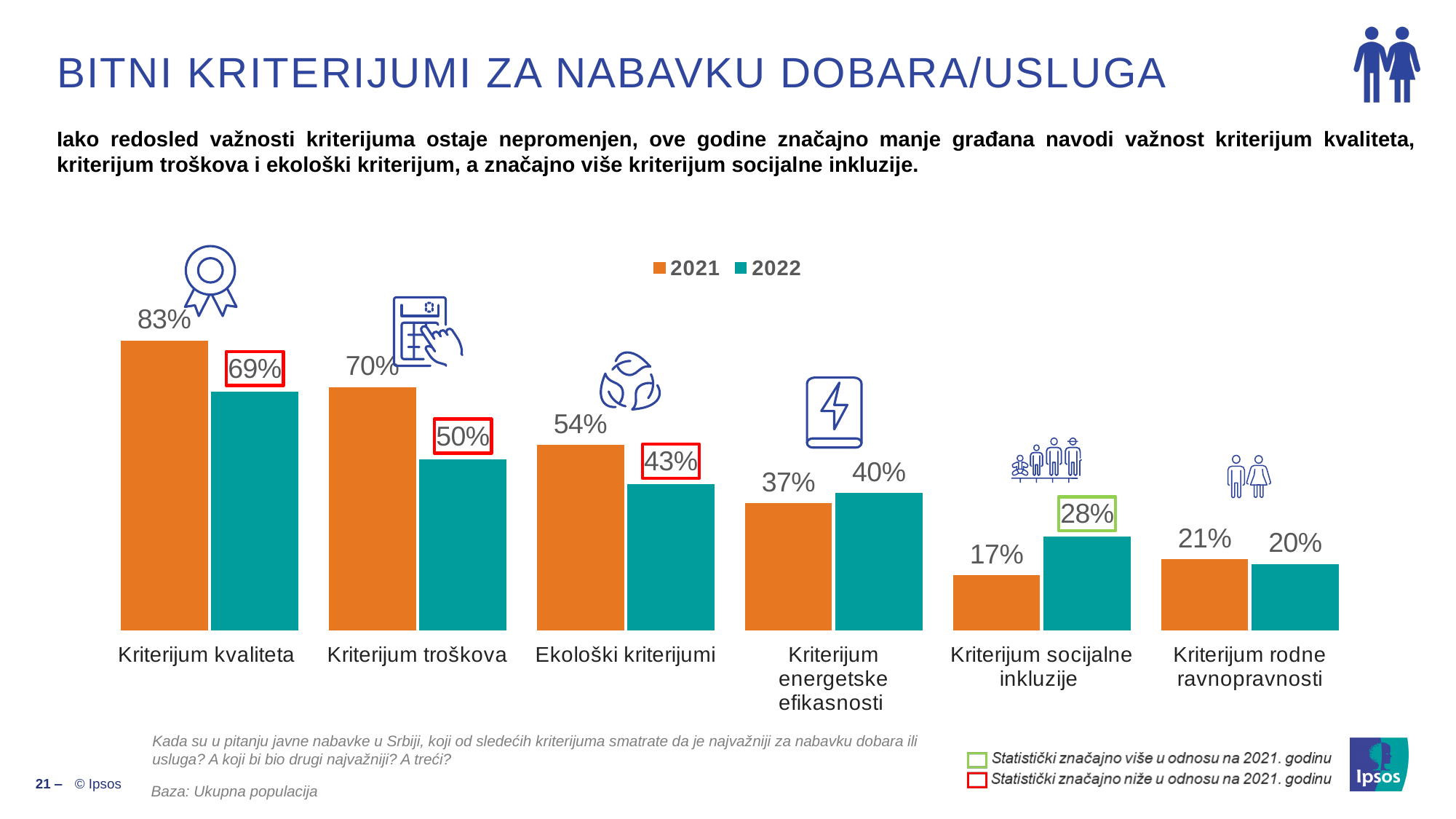
For Kriterijum rodne ravnopravnosti, which year has the larger value, 2021 or 2022? 2021 What is the 2021 value for Kriterijum kvaliteta? 83% Which category has the lowest 2021 value? Kriterijum socijalne inkluzije What is the 2021 value for Kriterijum energetske efikasnosti? 37% Which category has the highest 2022 value? Kriterijum kvaliteta Which colour represents the 2022 series in the chart? Teal What is the 2022 value for Kriterijum troškova? 50% What kind of chart is shown on the slide? Bar chart How many categories are shown on the x axis? 6 What is the difference between the 2021 and 2022 values for Ekološki kriterijumi? 11 percentage points How many series does the legend list? 2 What is the 2022 value for Kriterijum socijalne inkluzije? 28%